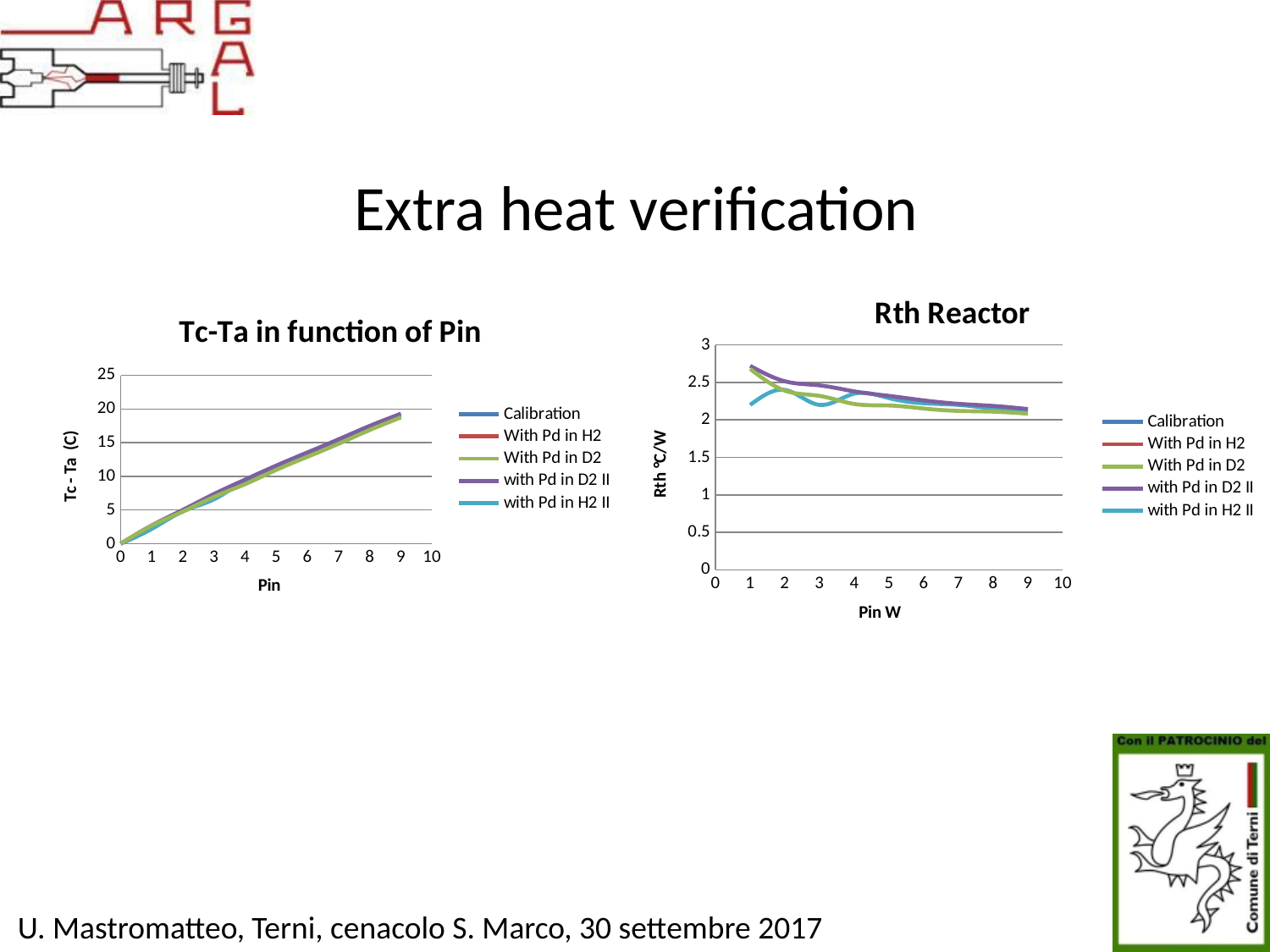
How many series does the legend of the 'Tc-Ta in function of Pin' chart list? 5 In the 'Rth Reactor' chart, do the values generally rise or fall as Pin W increases? fall How many series does the legend of the 'Rth Reactor' chart list? 5 What kind of chart is the 'Rth Reactor' chart? line chart What kind of chart is the 'Tc-Ta in function of Pin' chart? line chart In the 'Tc-Ta in function of Pin' chart, do the values rise or fall as Pin increases? rise In the 'Tc-Ta in function of Pin' chart, is the Calibration value at Pin 2 greater or less than 10? less In the 'Rth Reactor' chart, is the value for 'with Pd in H2 II' at Pin W 1 greater or less than 2.5? less In the 'Rth Reactor' chart, is the value for 'with Pd in D2 II' at Pin W 1 greater or less than 2.5? greater What is the y-axis label of the 'Rth Reactor' chart? Rth °C/W What is the x-axis label of the 'Tc-Ta in function of Pin' chart? Pin